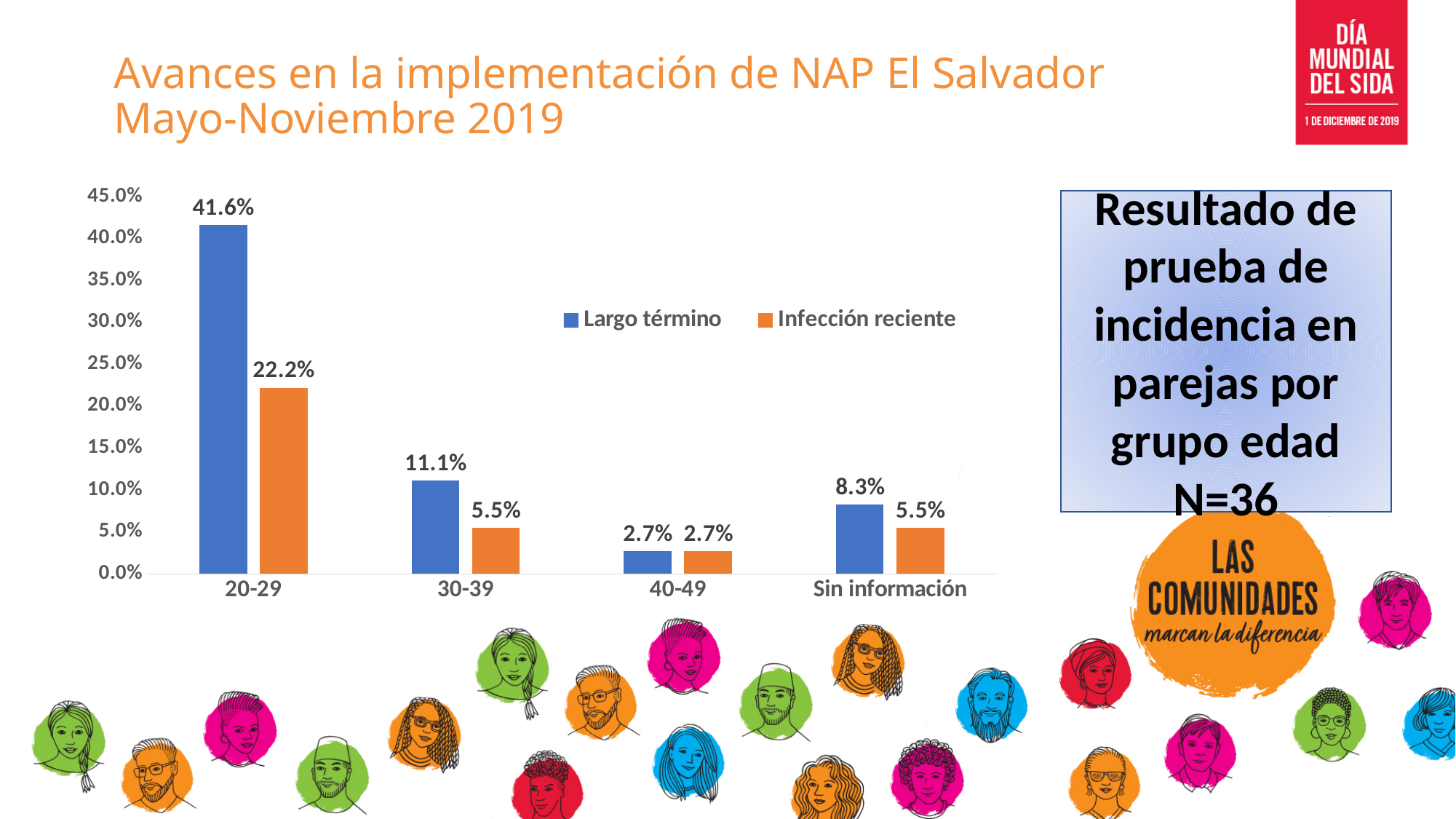
What is the value for Infección reciente in the 30-39 age group? 5.5% What colour represents the Infección reciente series? Orange Which is larger in the 30-39 age group, Largo término or Infección reciente? Largo término Which age group has the highest value for Infección reciente? 20-29 What is the value for Largo término in the Sin información category? 8.3% How many categories are shown on the x axis? 4 Which category has the lowest value for Largo término? 40-49 What kind of chart is shown on the slide? Bar chart How many series does the legend list? 2 Is the value for Largo término in the 20-29 age group greater or less than 40.0%? greater What is the difference between Largo término and Infección reciente in the 20-29 age group? 19.4% What is the value for Largo término in the 20-29 age group? 41.6%